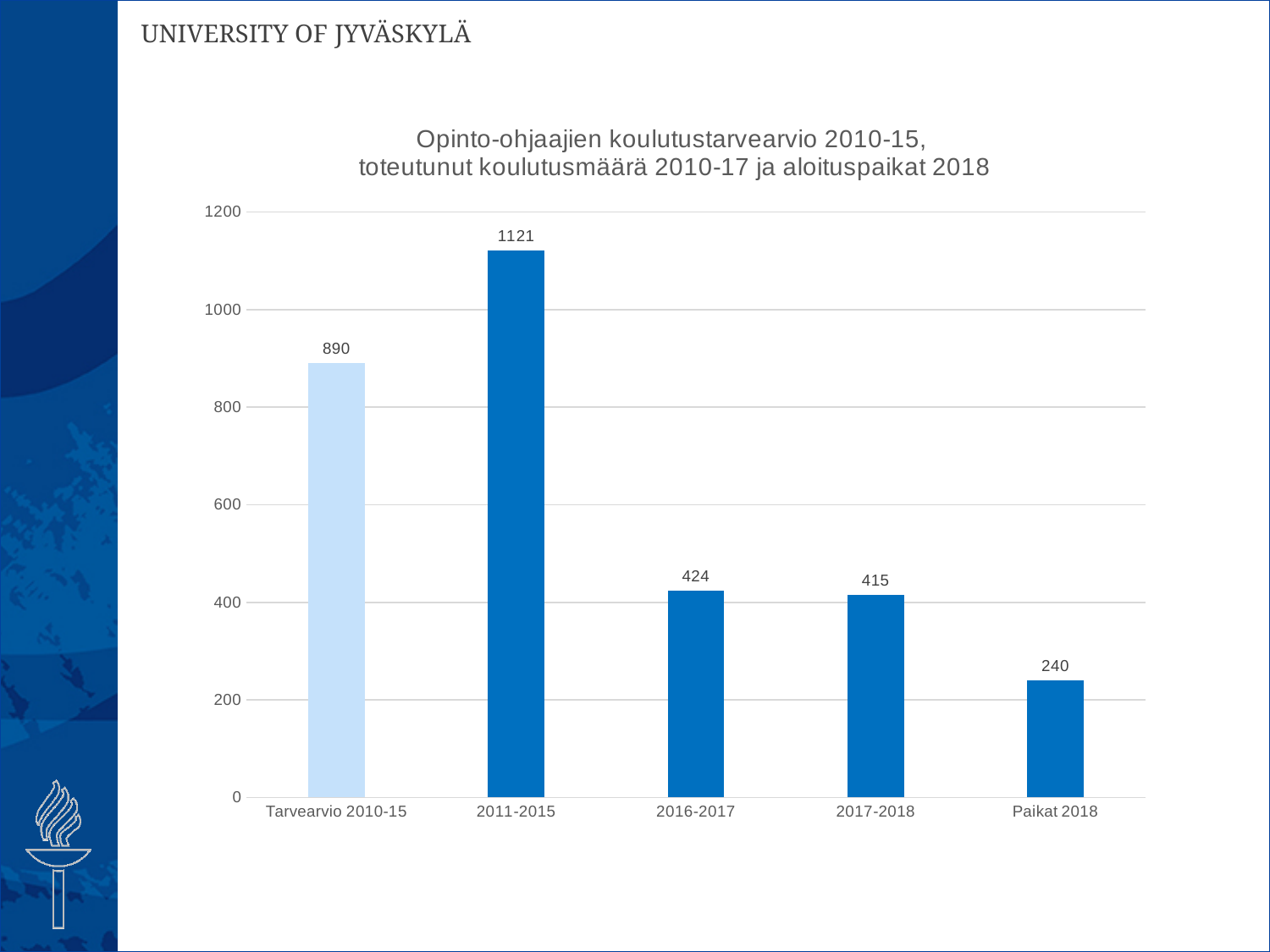
Which category has the highest value? 2011-2015 What kind of chart is shown on the slide? bar chart Which category has the lowest value? Paikat 2018 Which bar is shown in a lighter blue colour than the others? Tarvearvio 2010-15 How many categories are shown on the x axis? 5 What is the difference between the values for 2011-2015 and Tarvearvio 2010-15? 231 What is the value for 2011-2015? 1121 Is the value for 2017-2018 greater or less than 600? less Which is larger, the value for 2016-2017 or the value for Paikat 2018? 2016-2017 What is the value for Paikat 2018? 240 What is the difference between the values for 2016-2017 and 2017-2018? 9 What is the value for Tarvearvio 2010-15? 890